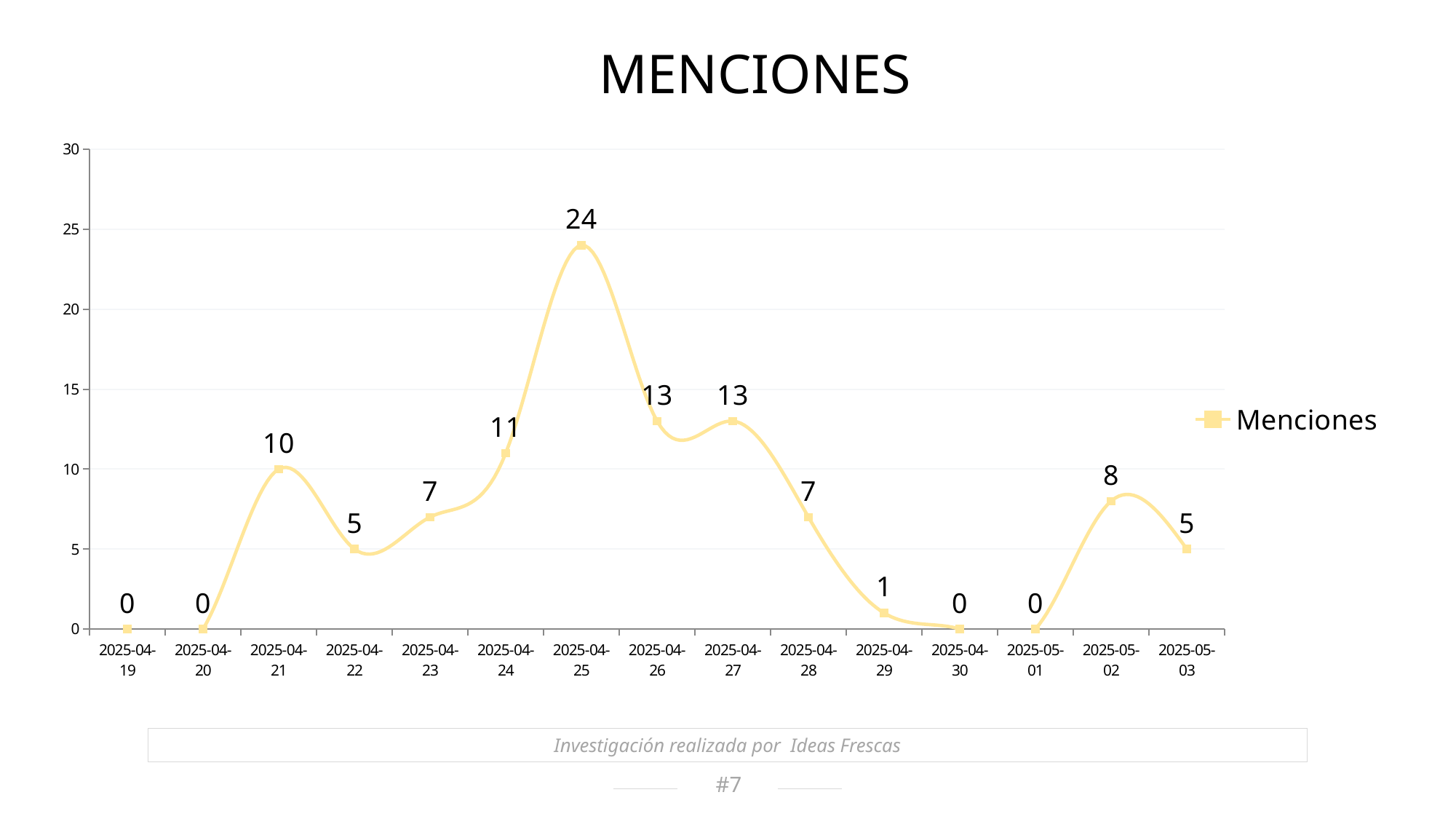
What kind of chart is shown? line chart What is the value for 2025-05-02? 8 Is the value for 2025-04-25 greater or less than 20? greater What is the difference between the values for 2025-04-25 and 2025-04-26? 11 What is the difference between the values for 2025-04-24 and 2025-04-23? 4 What is the title of the chart? MENCIONES Which date has the highest number of mentions? 2025-04-25 What is the value for 2025-04-25? 24 How many series does the legend list? 1 How many dates are plotted on the x axis? 15 What is the value for 2025-04-21? 10 Which is larger, the value for 2025-04-21 or the value for 2025-04-28? 2025-04-21